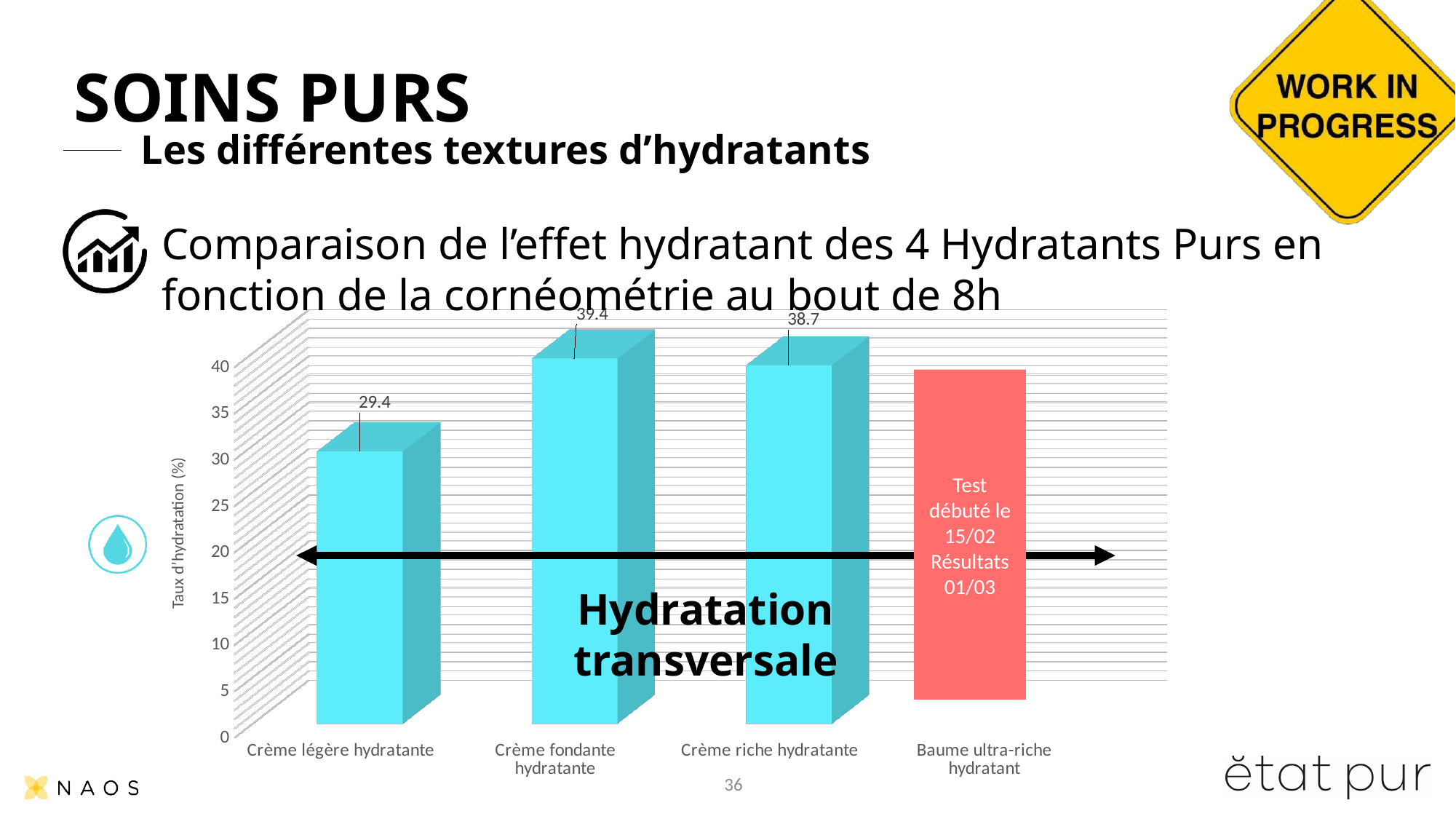
What is the difference between the values for Crème fondante hydratante and Crème riche hydratante? 0.7 What is the difference between the values for Crème fondante hydratante and Crème légère hydratante? 10 Which is larger, the value for Crème riche hydratante or Crème légère hydratante? Crème riche hydratante Which category has the highest plotted value? Crème fondante hydratante What is the value for Crème riche hydratante? 38.7 What kind of chart is shown on the slide? bar chart Is the value for Crème légère hydratante greater or less than 35? less Which category has the lowest plotted value? Crème légère hydratante What is the value for Crème légère hydratante? 29.4 What is the label of the vertical axis? Taux d'hydratation (%) What is the value for Crème fondante hydratante? 39.4 How many categories are shown on the x axis? 4